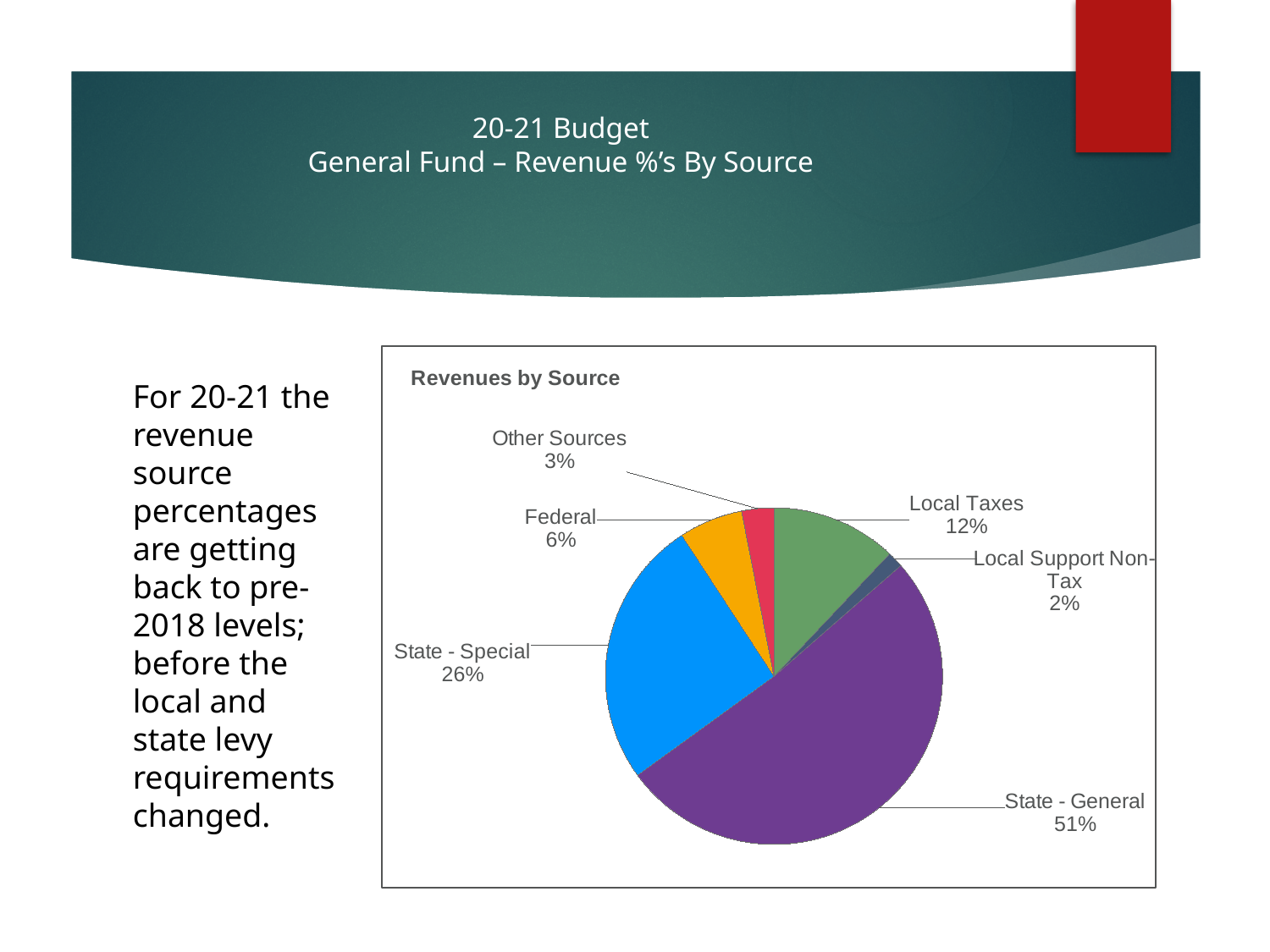
Which revenue source has the smallest share of the pie? Local Support Non-Tax What is the title of the chart? Revenues by Source Which is larger, the share for Federal or the share for Other Sources? Federal What percentage of revenue comes from State - General? 51% How many revenue source categories are shown in the pie chart? 6 Which revenue source has the largest share of the pie? State - General What percentage of revenue comes from Local Taxes? 12% What type of chart is shown on the slide? Pie chart What is the difference in percentage points between State - General and State - Special? 25 What is the combined share of State - General and State - Special? 77% What percentage of revenue comes from Local Support Non-Tax? 2% What percentage of revenue comes from Federal sources? 6%